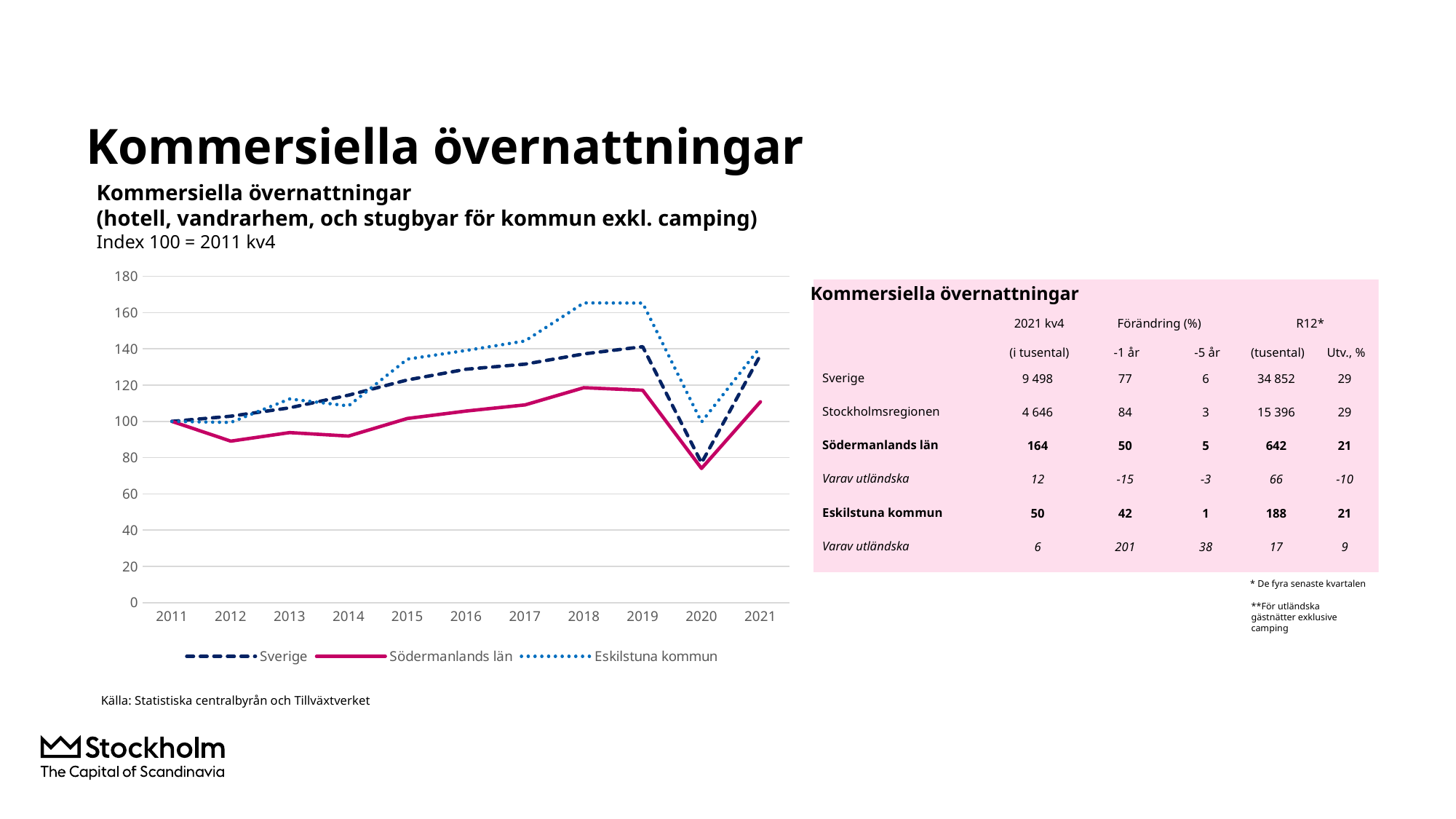
Is the value for Sverige in 2018 greater or less than 120? greater How many years are plotted along the x axis of the chart? 11 Does the value for Södermanlands län rise or fall from 2019 to 2020? fall Is the value for Södermanlands län in 2012 greater or less than 100? less How many series does the chart legend list? 3 Is the value for Eskilstuna kommun in 2018 greater or less than 160? greater Which series has the highest value in 2018? Eskilstuna kommun What kind of chart is shown on the slide? line chart In 2016, which is larger: the value for Sverige or the value for Södermanlands län? Sverige Which series has the lowest value in 2020? Södermanlands län What is the index base stated below the chart title? Index 100 = 2011 kv4 Does the value for Eskilstuna kommun rise or fall from 2014 to 2018? rise